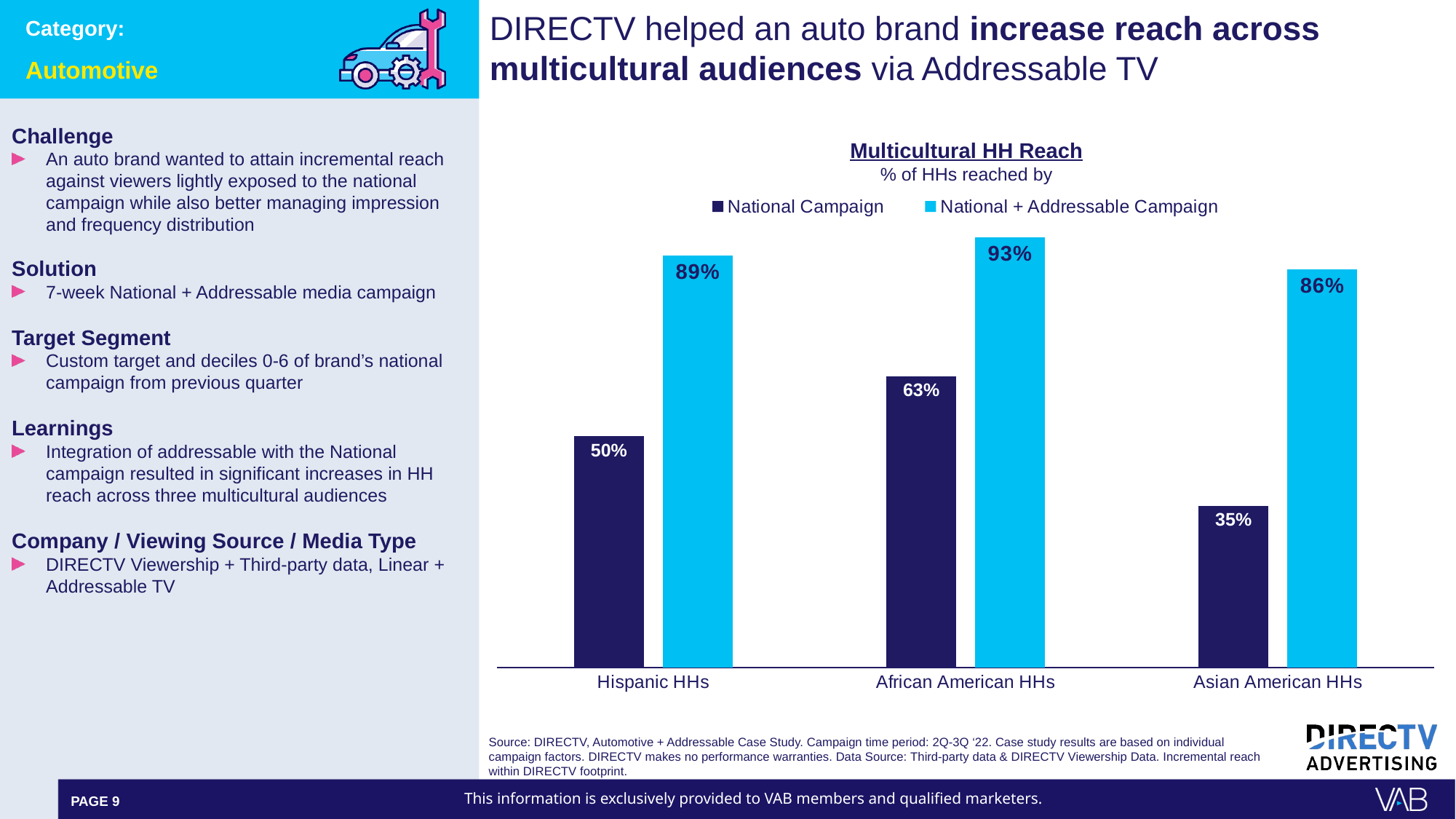
What is the difference between the National + Addressable Campaign and National Campaign reach for Asian American HHs? 51% What is the National Campaign reach for Hispanic HHs? 50% Which audience has the highest National + Addressable Campaign reach? African American HHs What is the difference between the National + Addressable Campaign and National Campaign reach for Hispanic HHs? 39% How many series does the legend list? 2 What is the National Campaign reach for Asian American HHs? 35% What is the title of the chart? Multicultural HH Reach What is the National + Addressable Campaign reach for African American HHs? 93% Which is larger: the National Campaign reach for African American HHs or for Hispanic HHs? African American HHs How many audience categories are shown on the x axis? 3 What kind of chart is shown on the slide? Bar chart Which audience has the lowest National Campaign reach? Asian American HHs